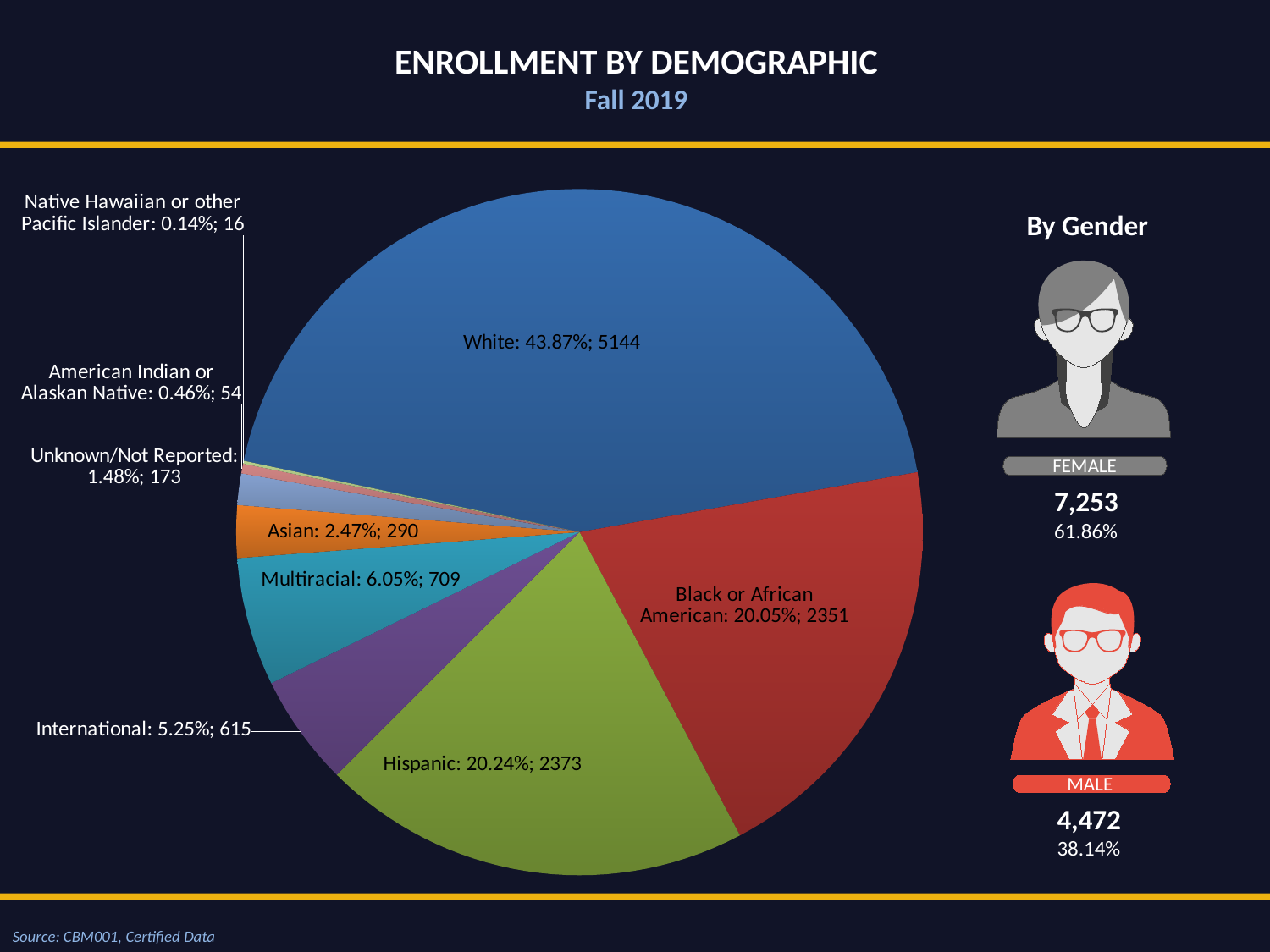
What is the enrollment count for the White slice of the pie chart? 5144 What is the difference in enrollment count between Hispanic and Black or African American students? 22 What is the enrollment count for Asian students? 290 What is the enrollment count for Black or African American students? 2351 Which category has the largest slice of the pie chart? White How many categories are shown in the pie chart? 9 Which has a larger enrollment count, Multiracial or International? Multiracial What is the title of the chart on the slide? Enrollment by Demographic What kind of chart is shown on the slide? Pie chart Which category has the smallest slice of the pie chart? Native Hawaiian or other Pacific Islander What percentage of enrollment is Unknown/Not Reported? 1.48% What percentage of enrollment does the Hispanic slice represent? 20.24%